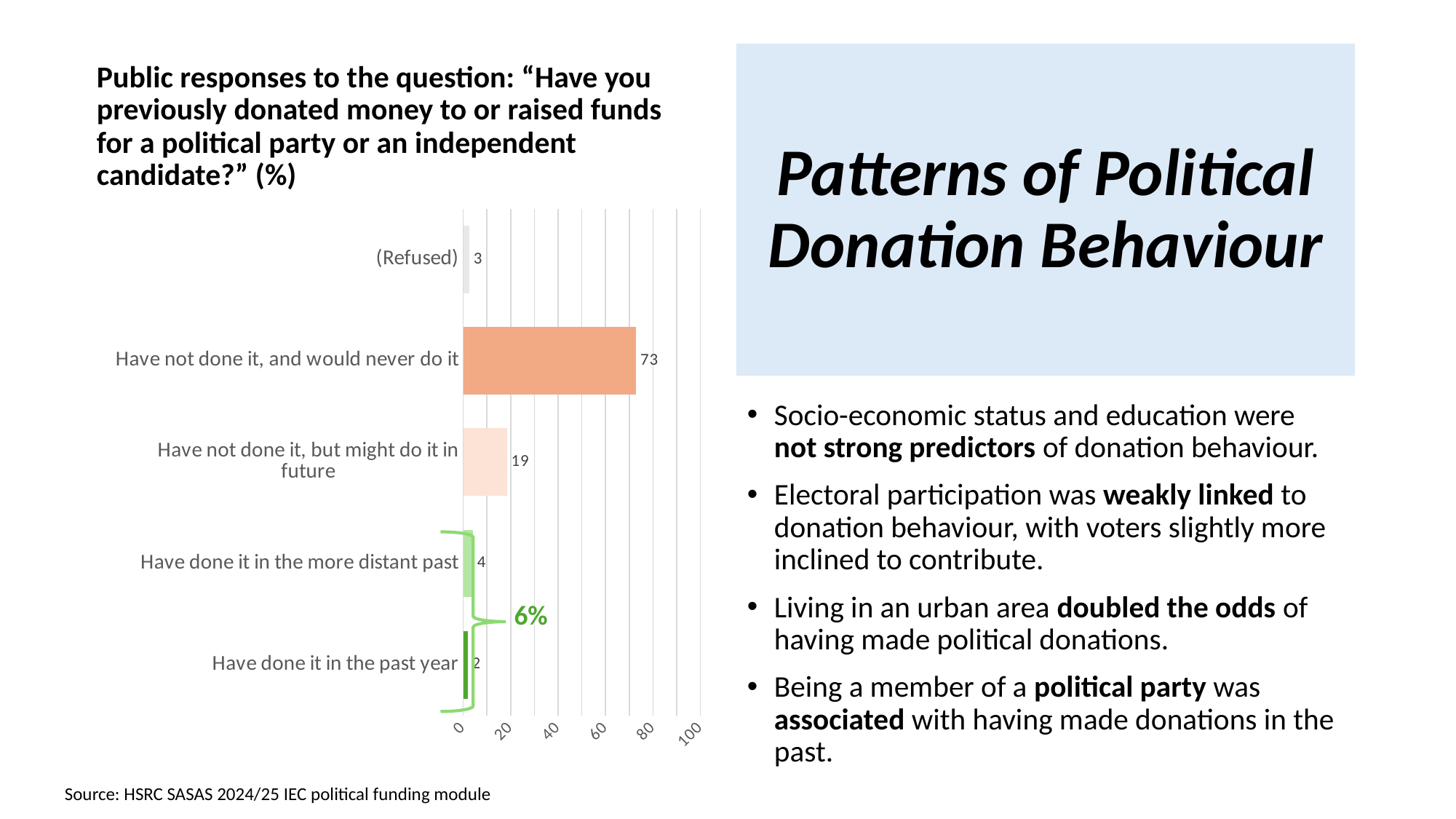
What value is shown for "(Refused)"? 3 Which response category has the highest value? Have not done it, and would never do it What kind of chart is shown on the slide? Bar chart What is the difference between the values for "Have not done it, and would never do it" and "Have not done it, but might do it in future"? 54 What value is shown for "Have done it in the more distant past"? 4 How many response categories are shown in the chart? 5 What value is shown for "Have not done it, and would never do it"? 73 Which is larger: the value for "(Refused)" or the value for "Have done it in the more distant past"? Have done it in the more distant past Which response category has the lowest value? Have done it in the past year What value is shown for "Have not done it, but might do it in future"? 19 What value is shown for "Have done it in the past year"? 2 What combined percentage is indicated by the green bracket next to the two "Have done it" categories? 6%